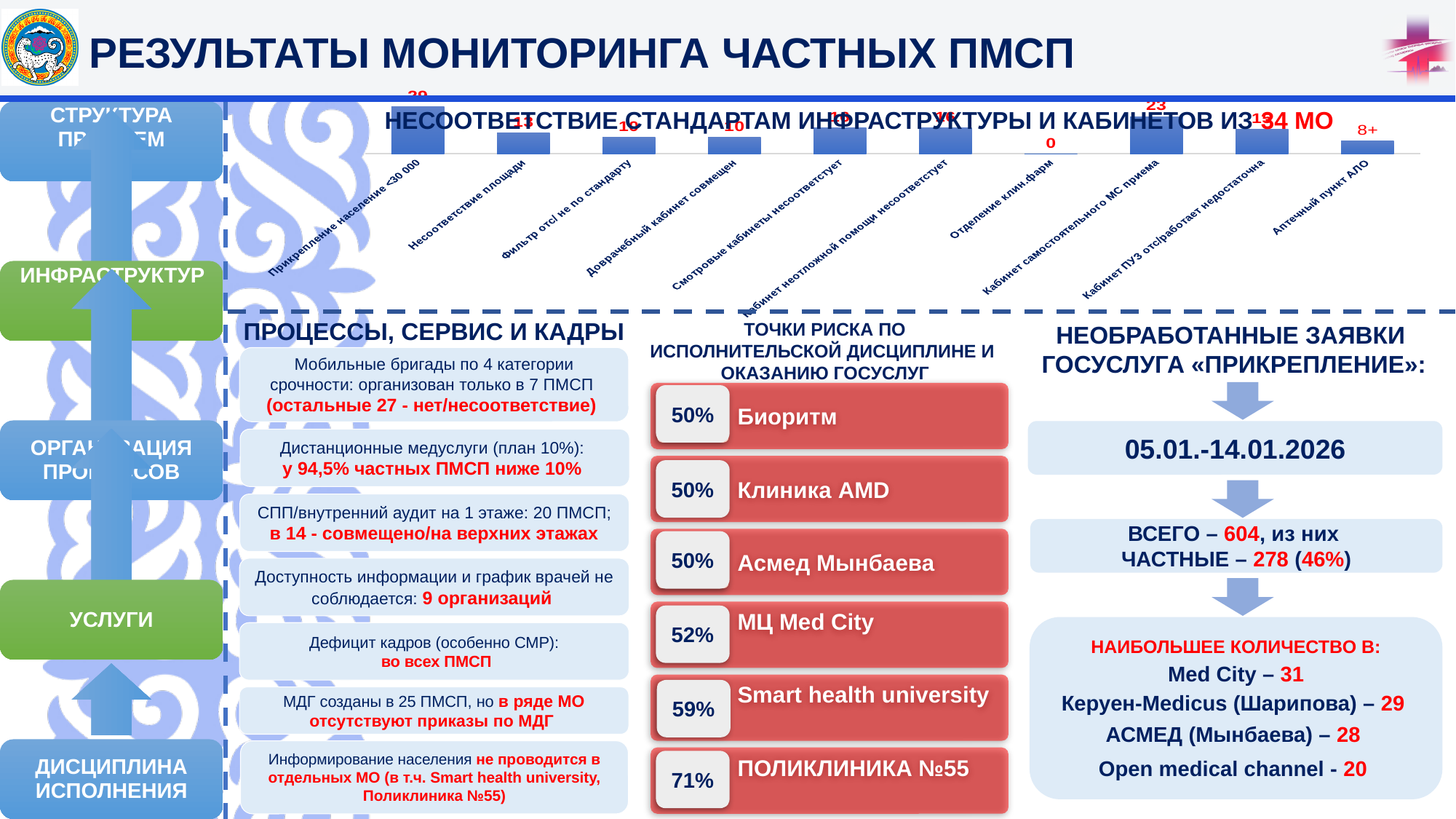
In the bar chart at the top of the slide, which is larger: 'Кабинет самостоятельного МС приема' or 'Аптечный пункт АЛО'? Кабинет самостоятельного МС приема What is the title of the bar chart at the top of the slide? НЕСООТВЕТСТВИЕ СТАНДАРТАМ ИНФРАСТРУКТУРЫ И КАБИНЕТОВ ИЗ 34 МО In the bar chart at the top of the slide, what is the difference between the values for 'Прикрепление население <30 000' and 'Кабинет самостоятельного МС приема'? 6 In the bar chart at the top of the slide, what is the value for 'Аптечный пункт АЛО'? 8+ In the bar chart at the top of the slide, what is the value for 'Прикрепление население <30 000'? 29 In the bar chart at the top of the slide, what is the value for 'Кабинет самостоятельного МС приема'? 23 What kind of chart is shown at the top of the slide under the heading 'НЕСООТВЕТСТВИЕ СТАНДАРТАМ ИНФРАСТРУКТУРЫ И КАБИНЕТОВ ИЗ 34 МО'? Bar chart In the bar chart at the top of the slide, which category has the lowest value? Отделение клин.фарм In the bar chart at the top of the slide, what is the value for 'Отделение клин.фарм'? 0 In the bar chart at the top of the slide, which is larger: 'Прикрепление население <30 000' or 'Кабинет самостоятельного МС приема'? Прикрепление население <30 000 In the bar chart at the top of the slide, which category has the tallest bar? Прикрепление население <30 000 How many categories are plotted in the bar chart at the top of the slide? 10